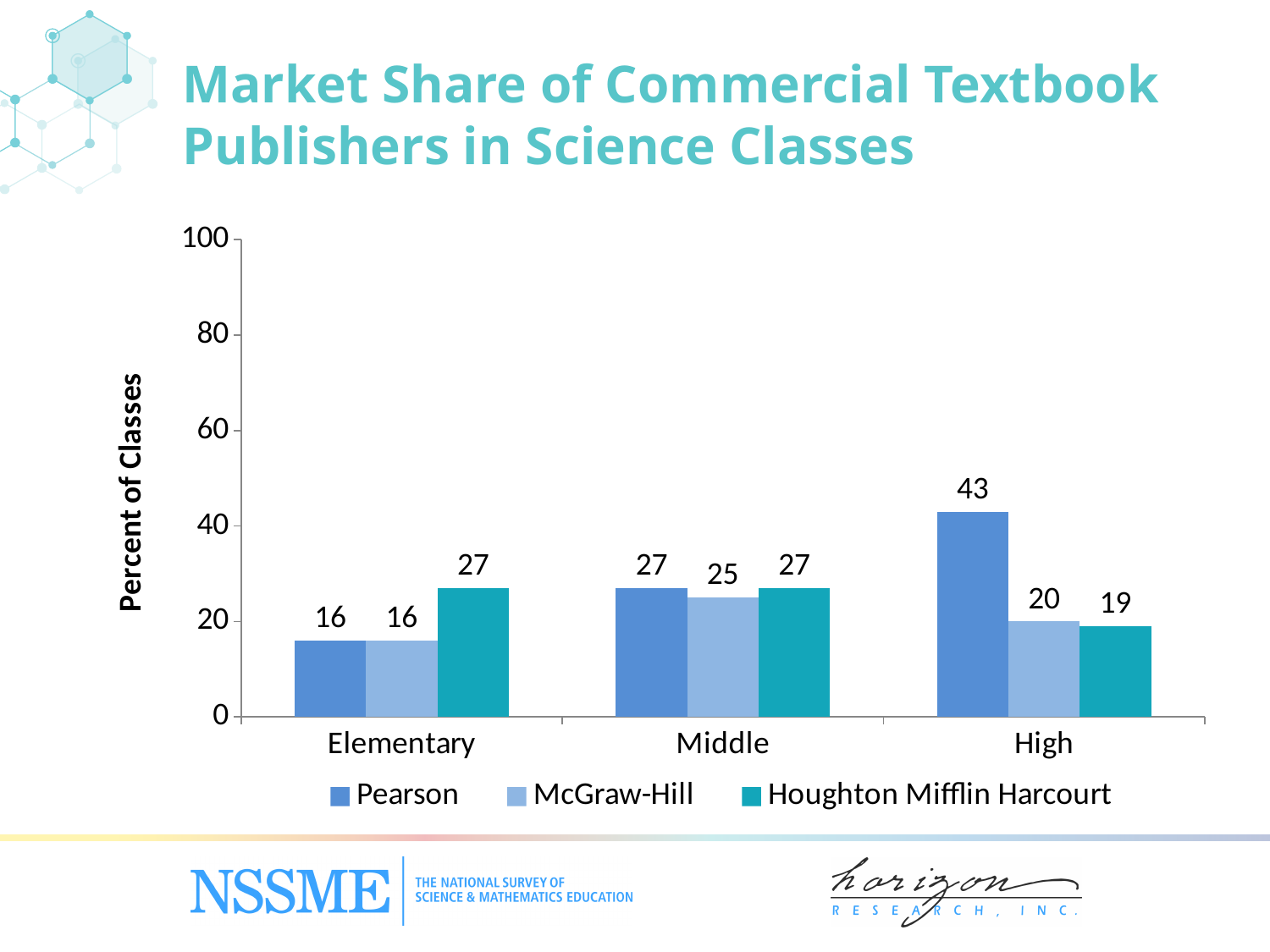
What is the value for McGraw-Hill in Middle? 25 Which is larger, Pearson in Middle or Pearson in Elementary? Pearson in Middle What kind of chart is shown on the slide? bar chart How many grade-level categories are shown on the x axis? 3 Is the value for Pearson in High greater or less than 40? greater What is the value for Houghton Mifflin Harcourt in Elementary? 27 How many series does the legend list? 3 What is the difference between Houghton Mifflin Harcourt and Pearson in Elementary? 11 Which publisher has the lowest value in High? Houghton Mifflin Harcourt What is the value for Pearson in High? 43 Which publisher has the highest value in High? Pearson What is the difference between Pearson and McGraw-Hill in High? 23